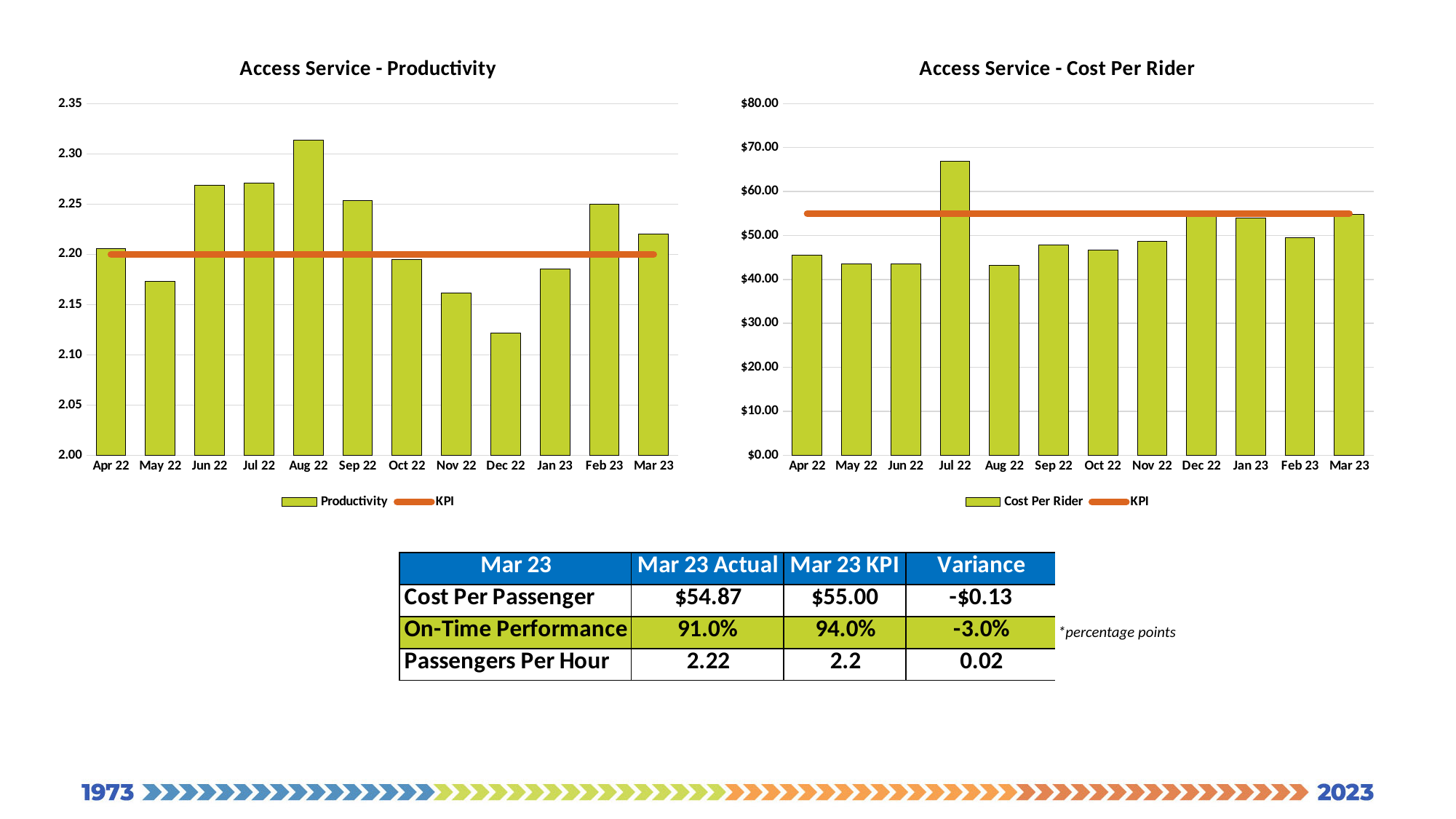
In the Access Service - Cost Per Rider chart, which is larger, the bar for Jul 22 or the bar for Aug 22? Jul 22 How many series does the legend of the Access Service - Cost Per Rider chart list? 2 What kind of chart is the Access Service - Productivity chart? Bar chart In the Access Service - Cost Per Rider chart, which month has the highest cost per rider? Jul 22 In the Access Service - Cost Per Rider chart, is the value for Apr 22 greater or less than $50.00? less In the Access Service - Productivity chart, which month has the lowest productivity bar? Dec 22 In the Access Service - Productivity chart, is the value for Nov 22 greater or less than 2.20? less In the Access Service - Productivity chart, which month has the highest productivity bar? Aug 22 In the Access Service - Productivity chart, which is larger, the bar for Jun 22 or the bar for May 22? Jun 22 In the Access Service - Productivity chart, is the value for Dec 22 greater or less than 2.15? less How many months are shown on the x axis of the Access Service - Productivity chart? 12